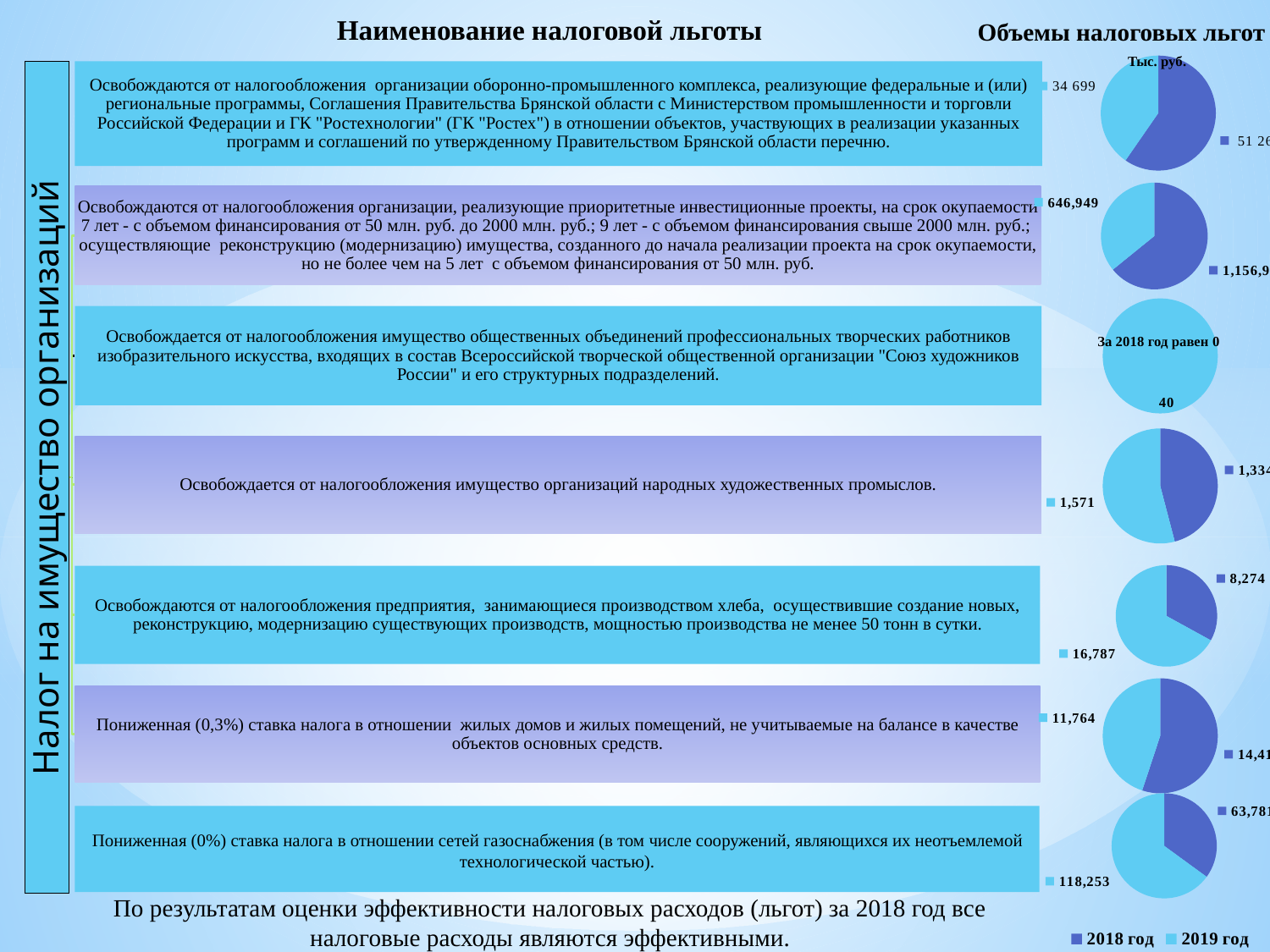
What kind of charts are shown in the right-hand column of the slide? pie chart How many series does the legend at the bottom of the slide list? 2 In the fifth pie chart from the top, what is the difference between the 2019 год value and the 2018 год value? 8,513 In the top pie chart (next to the row about оборонно-промышленного комплекса), what is the value for 2018 год? 34 699 In the bottom pie chart, which year has the larger value, 2018 год or 2019 год? 2019 год In the bottom pie chart (next to the row about сетей газоснабжения), what is the value for 2018 год? 63,781 In the fourth pie chart from the top (next to the row about народных художественных промыслов), what is the value for 2018 год? 1,334 In the bottom pie chart, what is the difference between the 2019 год value and the 2018 год value? 54,472 In the fifth pie chart from the top (next to the row about производством хлеба), what is the value for 2018 год? 8,274 In the bottom pie chart (next to the row about сетей газоснабжения), what is the value for 2019 год? 118,253 In the fifth pie chart from the top (next to the row about производством хлеба), what is the value for 2019 год? 16,787 In the fourth pie chart from the top (next to the row about народных художественных промыслов), what is the value for 2019 год? 1,571